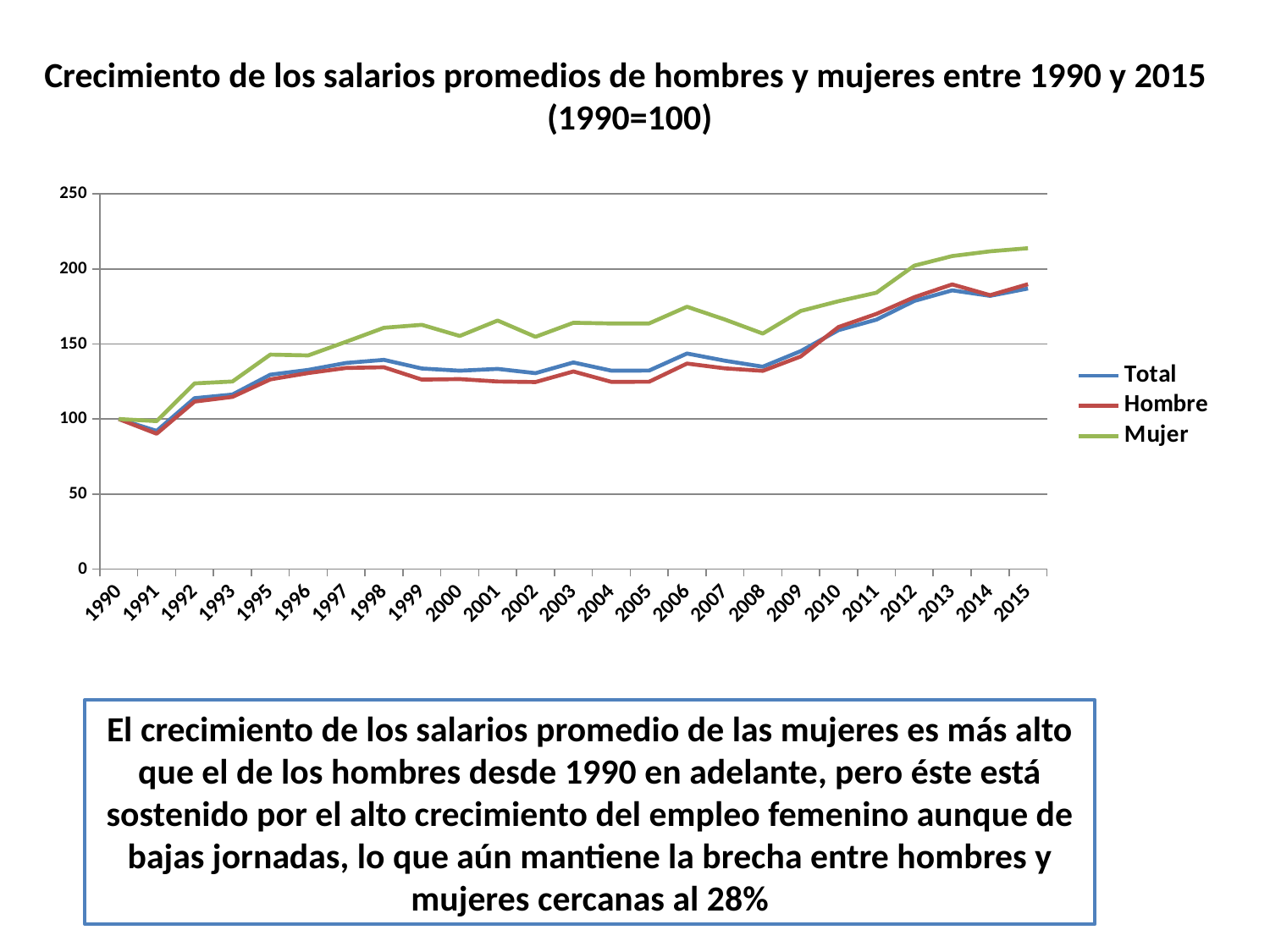
Is the value for Mujer in 2015 greater or less than 200? greater Which series has the lowest value in 1991? Hombre What kind of chart is shown on the slide? line chart What is the value of all three series in 1990? 100 Is the value for Hombre in 1991 greater or less than 100? less How many series does the legend list? 3 What are the names of the series in the legend? Total, Hombre, Mujer Is the value for Mujer in 2008 greater or less than 150? greater Do the values for Mujer generally rise or fall from 1990 to 2015? rise In 2010, which is larger: the value for Mujer or the value for Hombre? Mujer Which series has the highest value in 2015? Mujer